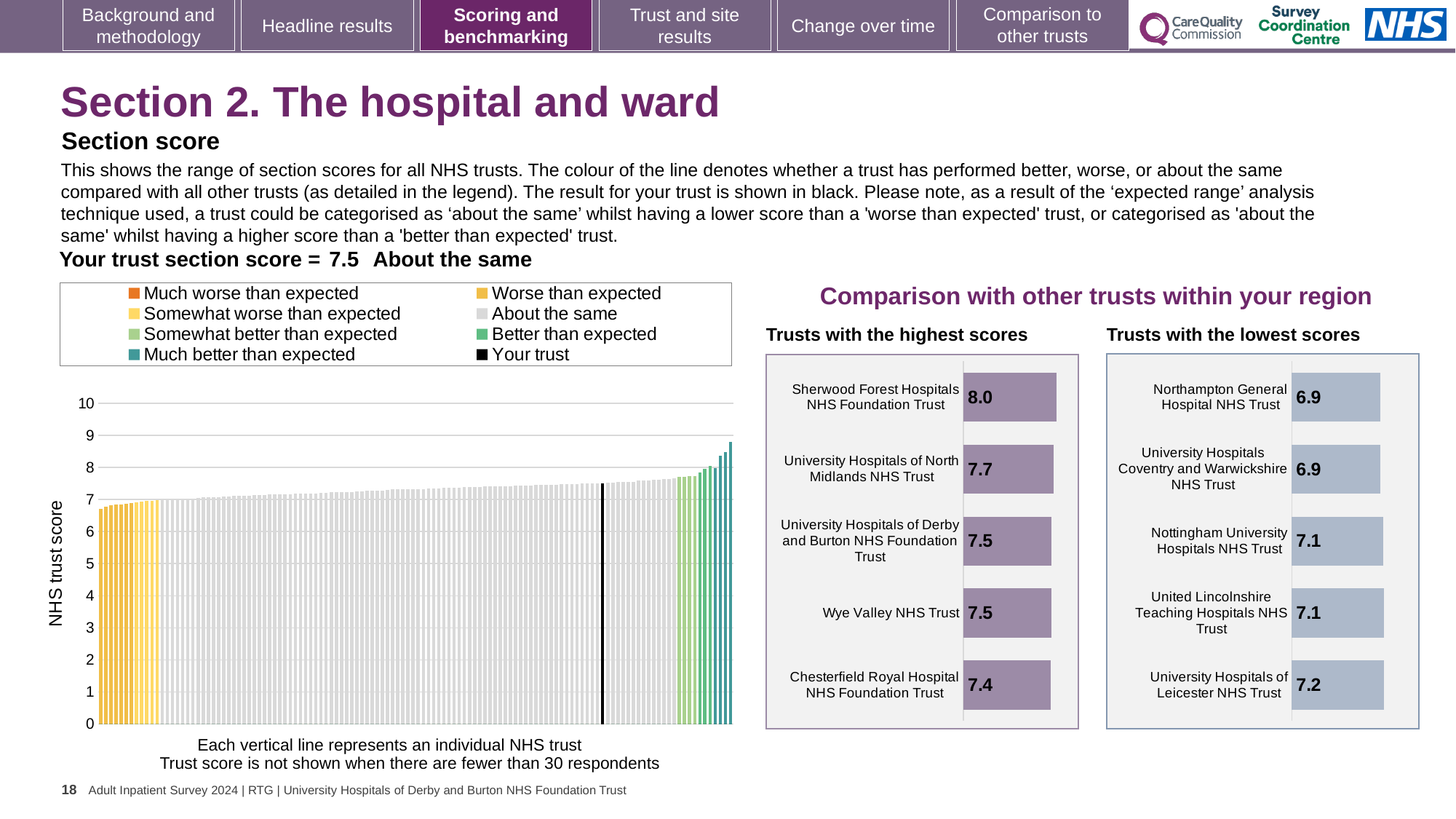
In the 'Trusts with the highest scores' chart, what is the score for University Hospitals of North Midlands NHS Trust? 7.7 In the large chart on the left showing all NHS trusts, do the scores rise or fall from left to right? rise In the 'Trusts with the lowest scores' chart, what is the difference between the scores of University Hospitals of Leicester NHS Trust and Northampton General Hospital NHS Trust? 0.3 In the 'Trusts with the lowest scores' chart, what is the score for Nottingham University Hospitals NHS Trust? 7.1 In the 'Trusts with the highest scores' chart, which trust has the lowest score? Chesterfield Royal Hospital NHS Foundation Trust What kind of chart is the large chart on the left showing all NHS trusts? bar chart In the 'Trusts with the highest scores' chart, how many trusts are shown? 5 In the 'Trusts with the highest scores' chart, what is the difference between the scores of Sherwood Forest Hospitals NHS Foundation Trust and Chesterfield Royal Hospital NHS Foundation Trust? 0.6 In the 'Trusts with the highest scores' chart, what is the score for Sherwood Forest Hospitals NHS Foundation Trust? 8.0 In the 'Trusts with the lowest scores' chart, which is larger: the score for University Hospitals of Leicester NHS Trust or Northampton General Hospital NHS Trust? University Hospitals of Leicester NHS Trust In the large chart on the left showing all NHS trusts, how many entries does the legend list? 8 In the 'Trusts with the lowest scores' chart, which trust has the highest score? University Hospitals of Leicester NHS Trust